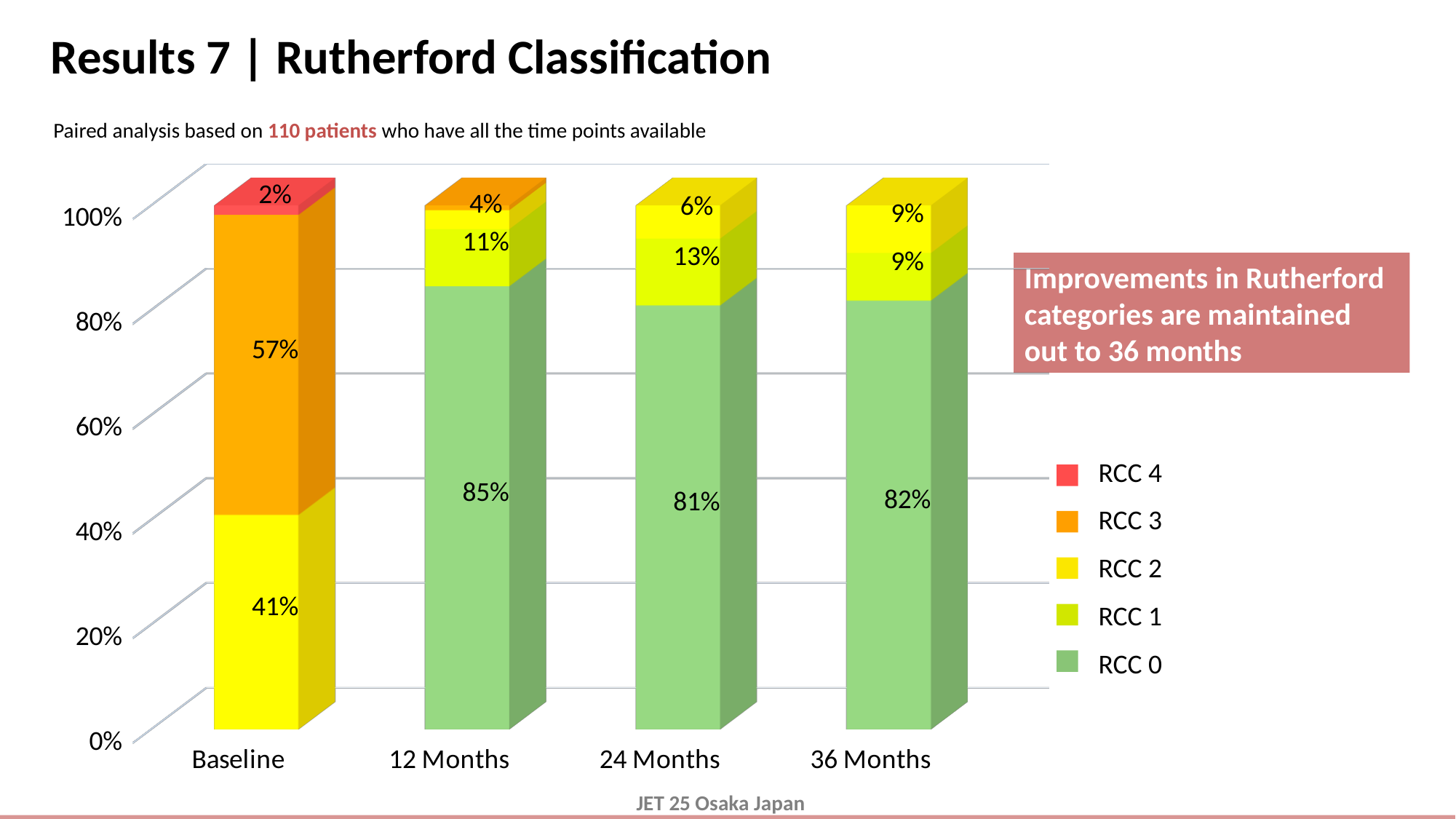
What is the RCC 3 percentage at Baseline? 57% How many time points (categories) are shown on the x axis? 4 Does the RCC 3 share rise or fall from Baseline to 12 Months? Fall What is the difference between the RCC 0 share at 12 Months and at 24 Months? 4 percentage points At which time point is the RCC 0 share highest? 12 Months What kind of chart is shown on the slide? Stacked bar chart Is the RCC 1 share larger at 24 Months or at 36 Months? 24 Months What is the RCC 0 percentage at 36 Months? 82% What is the RCC 2 percentage at Baseline? 41% How many series does the legend list? 5 What is the RCC 4 percentage at Baseline? 2% What is the RCC 0 percentage at 12 Months? 85%